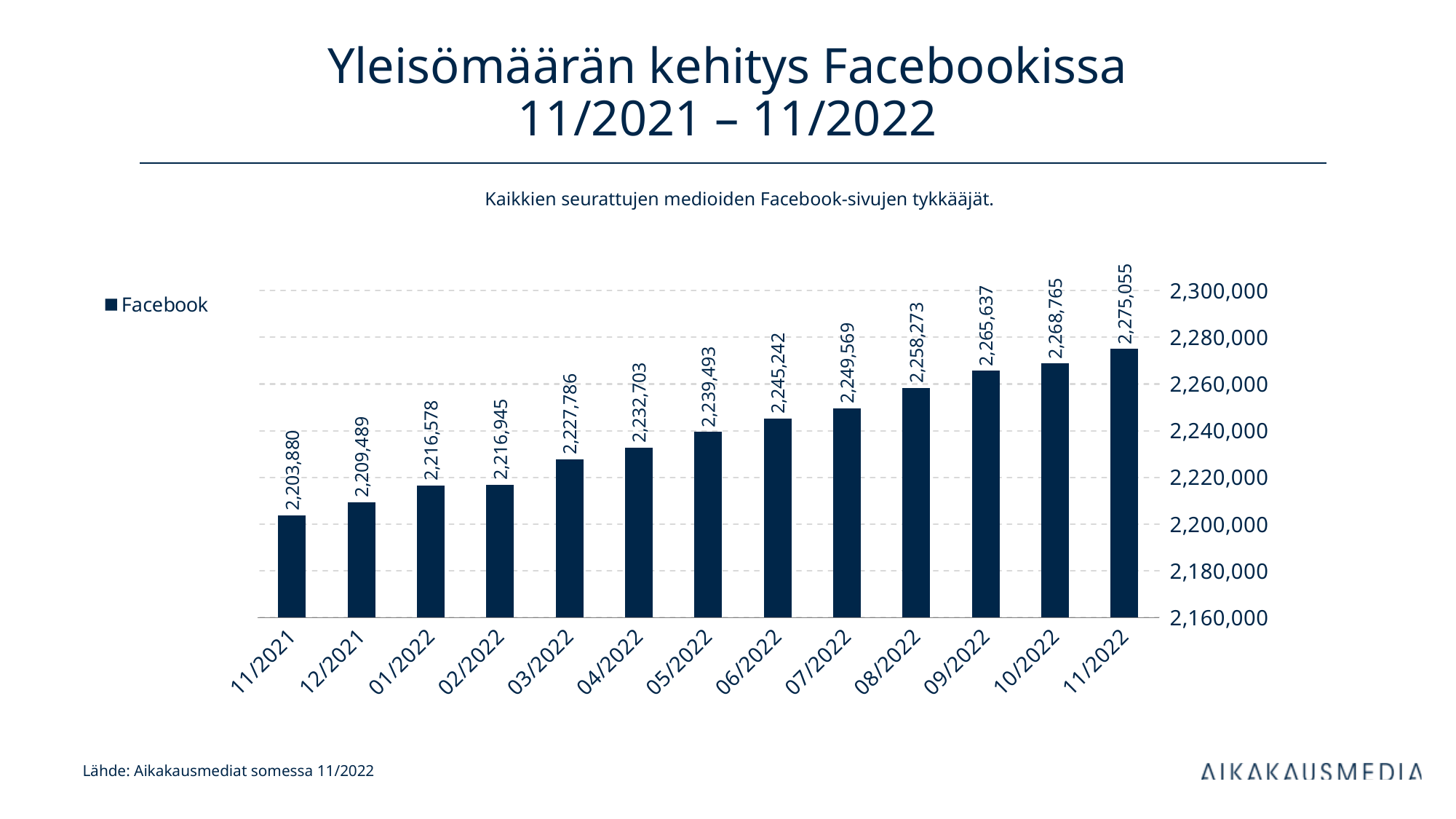
What is the value for 06/2022? 2,245,242 Which month has the highest value? 11/2022 Do the values rise or fall from 11/2021 to 11/2022? rise What is the difference between the values for 11/2022 and 11/2021? 71,175 Is the value for 08/2022 greater or less than 2,240,000? greater What is the value for 11/2021? 2,203,880 Which is larger, the value for 03/2022 or the value for 05/2022? 05/2022 Which month has the lowest value? 11/2021 What is the difference between the values for 10/2022 and 09/2022? 3,128 What kind of chart is shown on the slide? bar chart How many months are shown on the x axis? 13 What is the value for 11/2022? 2,275,055